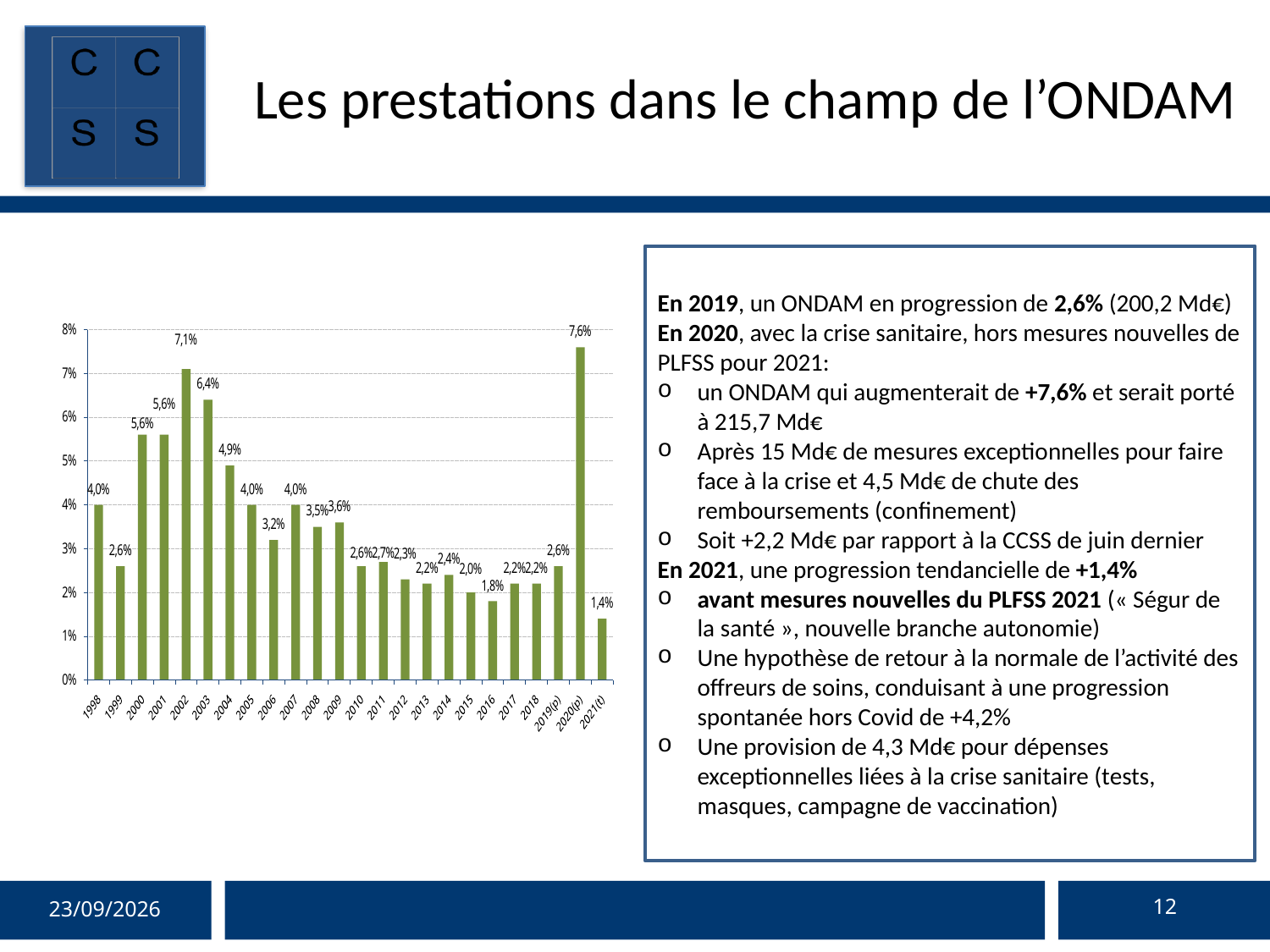
What is the difference between the values for 2002 and 2003? 0,7 points What is the value shown for 2016? 1,8% What is the value shown for 2002? 7,1% What type of chart is shown on the slide? bar chart Which year has the lowest value in the chart? 2021(t) Do the values generally rise or fall from 2002 to 2016? fall Is the value for 2003 greater or less than 6%? greater What is the value shown for 2021(t)? 1,4% Which is larger, the value for 2004 or the value for 2005? 2004 What is the value shown for 2020(p)? 7,6% Which year has the highest value in the chart? 2020(p) How many bars (years) are plotted in the chart? 24